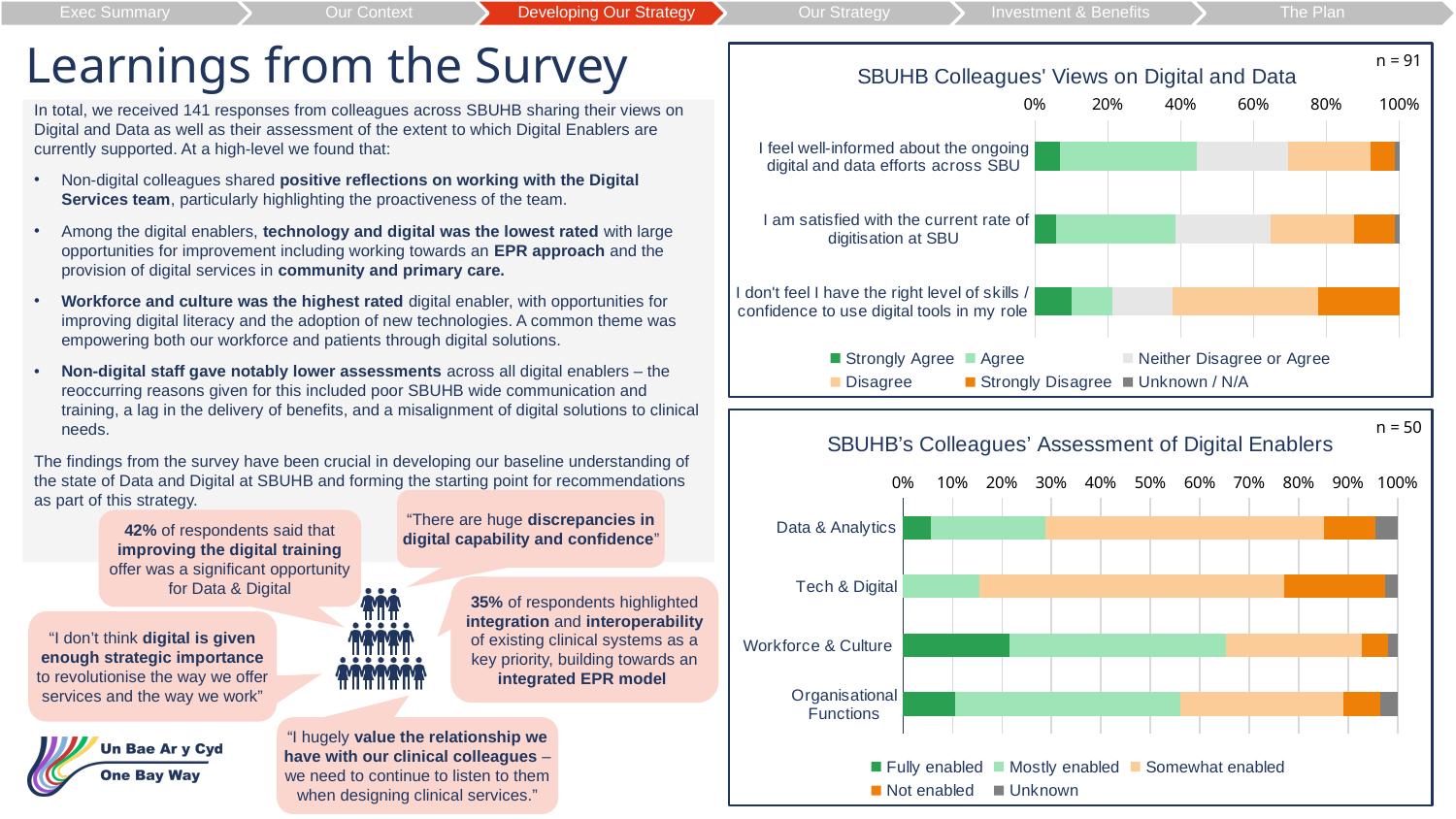
How many statements are plotted in the 'SBUHB Colleagues' Views on Digital and Data' chart? 3 What type of chart is 'SBUHB's Colleagues' Assessment of Digital Enablers'? Stacked bar chart In the 'SBUHB Colleagues' Views on Digital and Data' chart, which statement has the smallest 'Agree' share? I don't feel I have the right level of skills / confidence to use digital tools in my role How many digital enablers are plotted in the 'SBUHB's Colleagues' Assessment of Digital Enablers' chart? 4 What type of chart is 'SBUHB Colleagues' Views on Digital and Data'? Stacked bar chart What sample size (n) is shown for the 'SBUHB Colleagues' Views on Digital and Data' chart? n = 91 In the 'SBUHB's Colleagues' Assessment of Digital Enablers' chart, is the 'Fully enabled' share for Workforce & Culture greater or less than 10%? greater How many series does the legend of the 'SBUHB Colleagues' Views on Digital and Data' chart list? 6 In the 'SBUHB Colleagues' Views on Digital and Data' chart, which statement has the largest 'Strongly Disagree' share? I don't feel I have the right level of skills / confidence to use digital tools in my role How many series does the legend of the 'SBUHB's Colleagues' Assessment of Digital Enablers' chart list? 5 In the 'SBUHB's Colleagues' Assessment of Digital Enablers' chart, which has the larger 'Fully enabled' share: Workforce & Culture or Data & Analytics? Workforce & Culture In the 'SBUHB's Colleagues' Assessment of Digital Enablers' chart, which enabler has the largest 'Not enabled' share? Tech & Digital